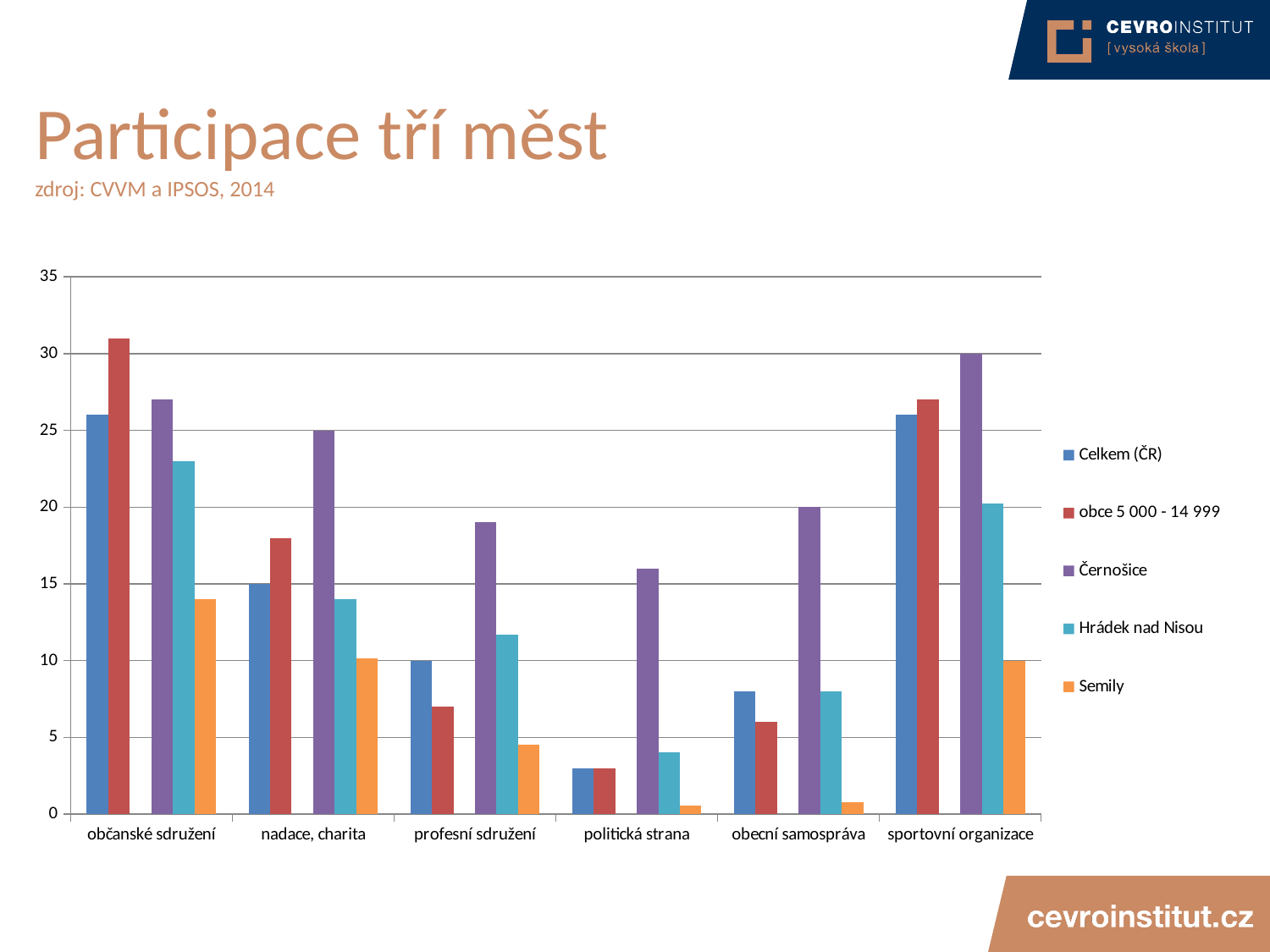
Is the value for Hrádek nad Nisou in profesní sdružení greater or less than 10? greater In politická strana, which is larger: Černošice or Hrádek nad Nisou? Černošice Which category has the lowest value for Semily? politická strana What is the title of the slide containing the chart? Participace tří měst How many series does the legend list? 5 Is the value for obce 5 000 - 14 999 in občanské sdružení greater or less than 30? greater What kind of chart is shown on the slide? bar chart How many categories are shown on the x axis? 6 Which category has the highest value for Černošice? sportovní organizace Which series has the highest value in obecní samospráva? Černošice Is the value for Celkem (ČR) in politická strana greater or less than 5? less